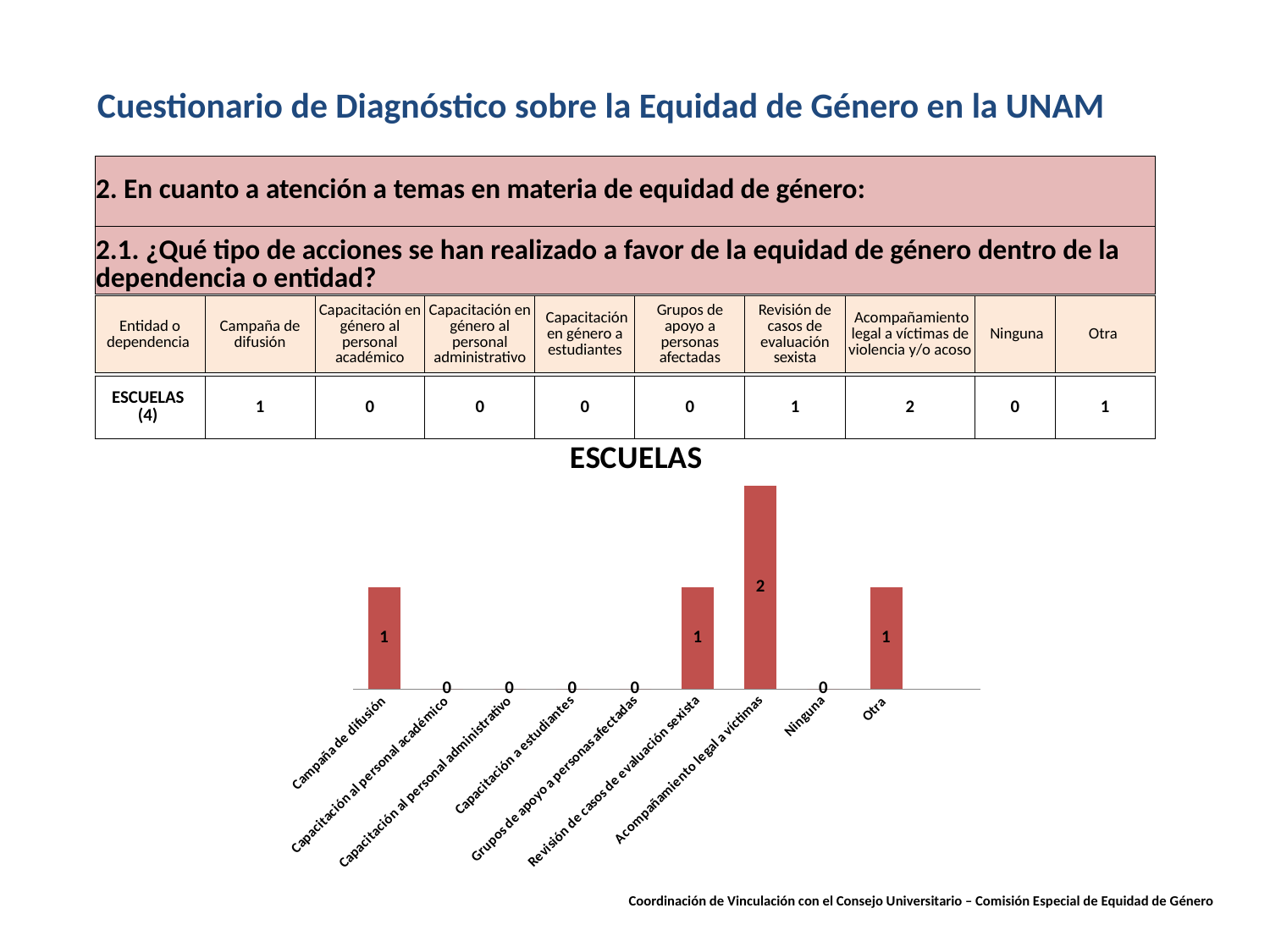
How many categories in the ESCUELAS chart have a value of 0? 5 What is the value for Capacitación a estudiantes in the ESCUELAS chart? 0 What is the value for Acompañamiento legal a víctimas in the ESCUELAS chart? 2 What is the title of the chart? ESCUELAS What is the value for Ninguna in the ESCUELAS chart? 0 What kind of chart is shown on the slide? bar chart Which is larger in the ESCUELAS chart, the value for Acompañamiento legal a víctimas or the value for Campaña de difusión? Acompañamiento legal a víctimas What is the value for Campaña de difusión in the ESCUELAS chart? 1 How many categories are plotted in the ESCUELAS chart? 9 Which category has the highest value in the ESCUELAS chart? Acompañamiento legal a víctimas What is the difference between the values for Acompañamiento legal a víctimas and Otra in the ESCUELAS chart? 1 What is the value for Revisión de casos de evaluación sexista in the ESCUELAS chart? 1